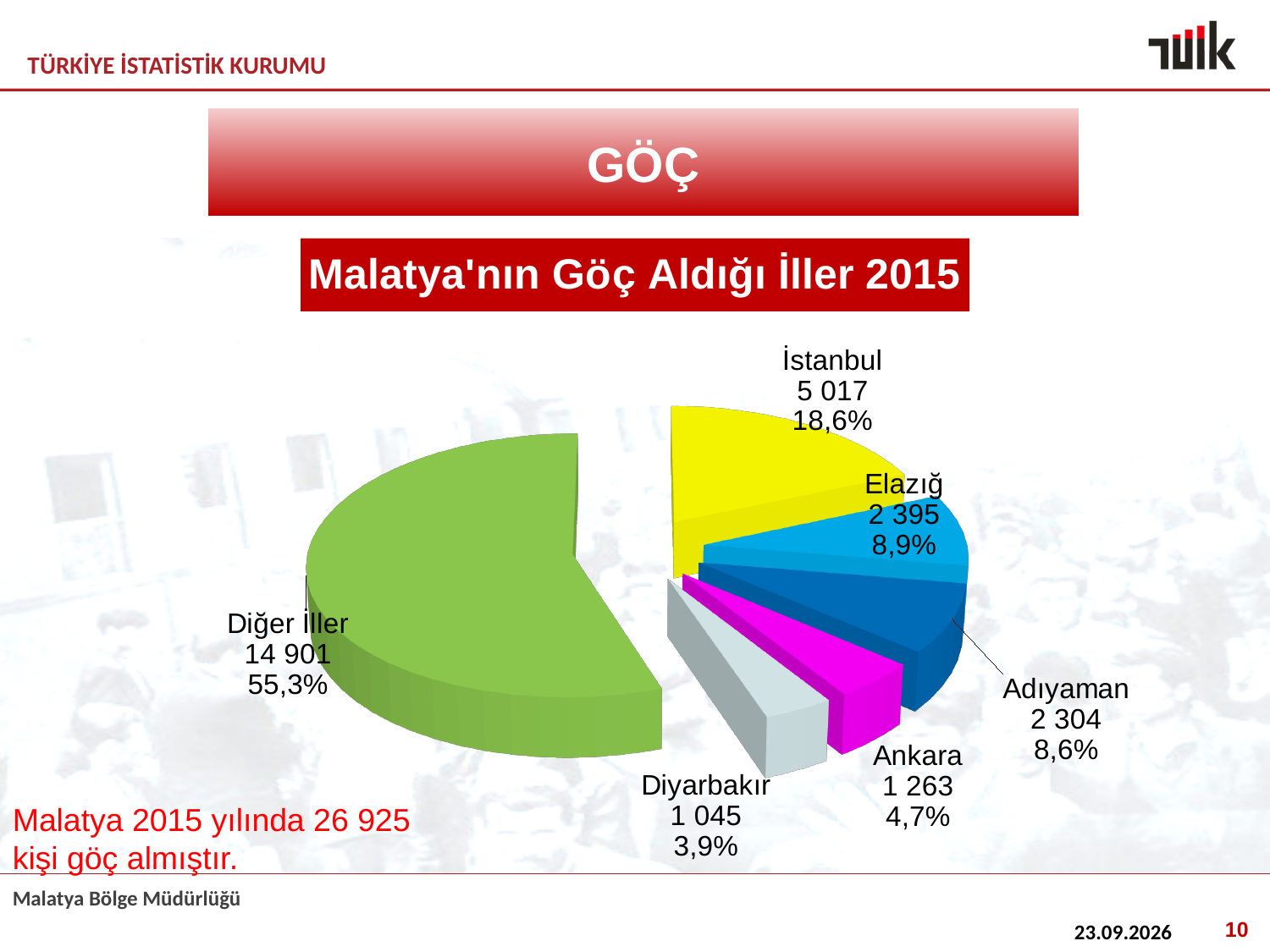
Which slice is the largest? Diğer İller How many slices does the pie chart have? 6 What is the value shown for Diyarbakır? 1 045 What is the value shown for Elazığ? 2 395 What is the difference between the values for İstanbul and Elazığ? 2 622 What is the value shown for İstanbul? 5 017 What share of the pie does Diğer İller represent? 55,3% What share of the pie does Adıyaman represent? 8,6% What kind of chart is shown on the slide? pie chart Which is larger, the value for Ankara or the value for Diyarbakır? Ankara What is the title of the chart? Malatya'nın Göç Aldığı İller 2015 Which slice is the smallest? Diyarbakır